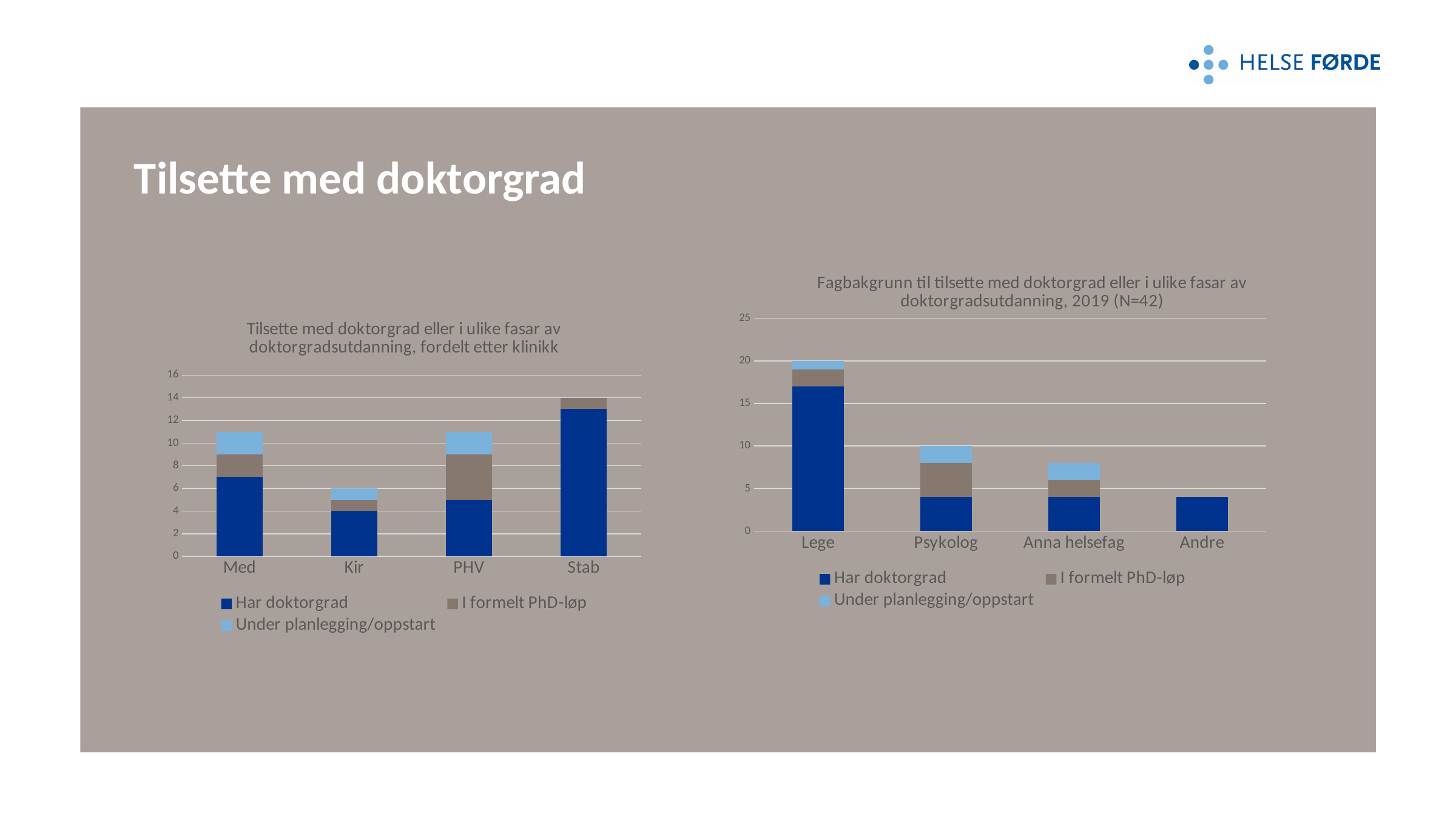
On the right chart (Fagbakgrunn, 2019), what is the total height of the stacked bar for Lege? 20 On the left chart (fordelt etter klinikk), how many clinics are shown on the x axis? 4 On the left chart (fordelt etter klinikk), which clinic has the tallest stacked bar? Stab On the right chart (Fagbakgrunn, 2019), which stacked bar is taller, Psykolog or Anna helsefag? Psykolog On the left chart (fordelt etter klinikk), what is the total height of the stacked bar for Kir? 6 On the right chart (Fagbakgrunn, 2019), is the Har doktorgrad value for Lege greater or less than 15? greater On the left chart (fordelt etter klinikk), how many series does the legend list? 3 On the right chart (Fagbakgrunn, 2019), what sample size (N) is stated in the chart title? N=42 On the left chart (fordelt etter klinikk), is the Har doktorgrad value for Stab greater or less than 12? greater On the right chart (Fagbakgrunn, 2019), which category has the tallest stacked bar? Lege On the left chart (fordelt etter klinikk), what kind of chart is shown? Stacked bar chart On the left chart (fordelt etter klinikk), which clinic has the shortest stacked bar? Kir